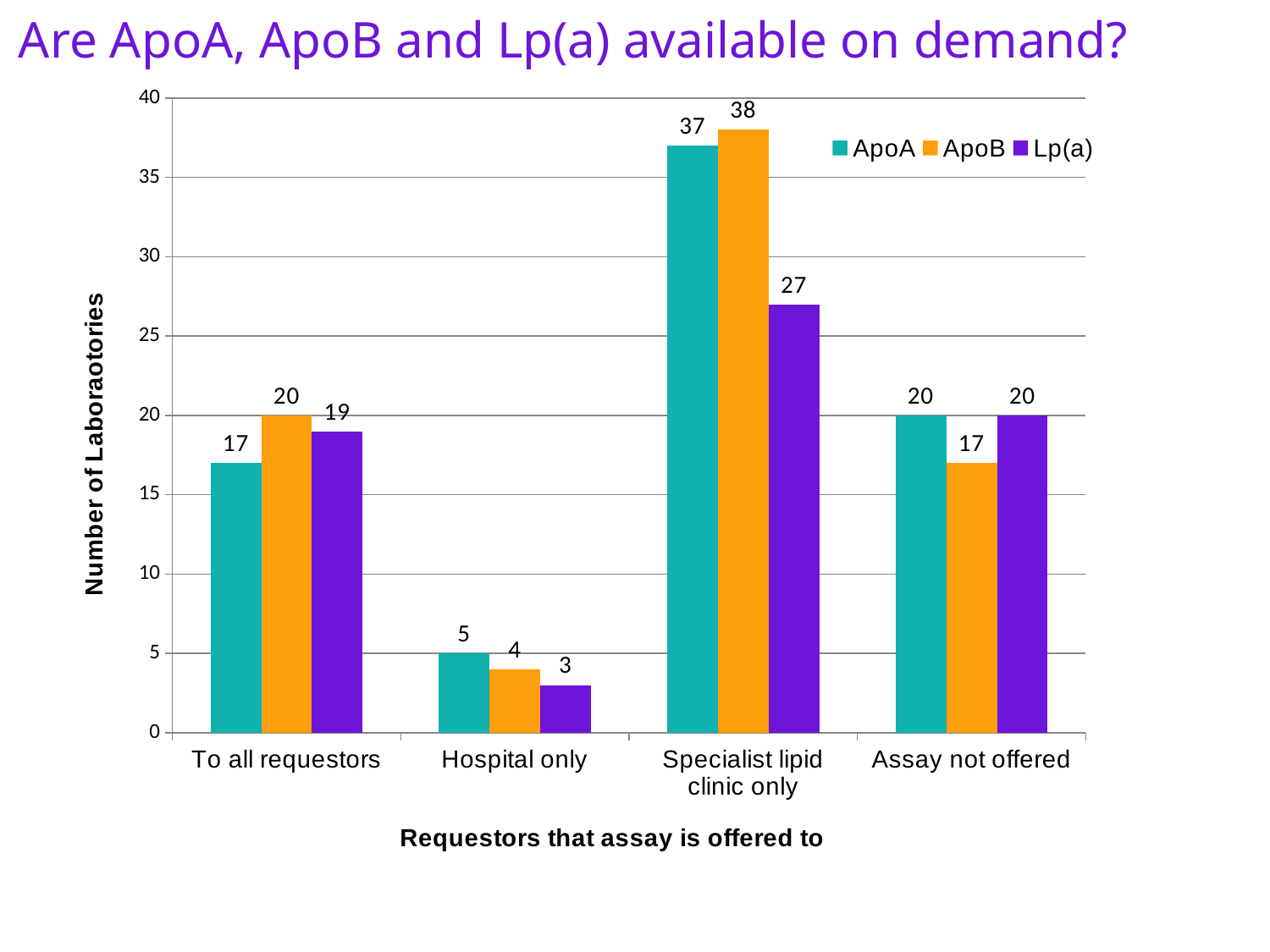
What is the difference between the ApoB and Lp(a) values in the 'Specialist lipid clinic only' category? 11 Which category has the lowest value for ApoB? Hospital only What kind of chart is shown on the slide? Bar chart Which category has the highest value for Lp(a)? Specialist lipid clinic only What is the label of the y axis? Number of Laboraotories What is the value for ApoA in the 'Hospital only' category? 5 Is the value for ApoA in the 'Specialist lipid clinic only' category greater or less than 35? greater In the 'Assay not offered' category, which is larger: ApoA or ApoB? ApoA What is the value for Lp(a) in the 'To all requestors' category? 19 How many categories are shown on the x axis? 4 How many series does the legend list? 3 What is the value for ApoB in the 'Specialist lipid clinic only' category? 38